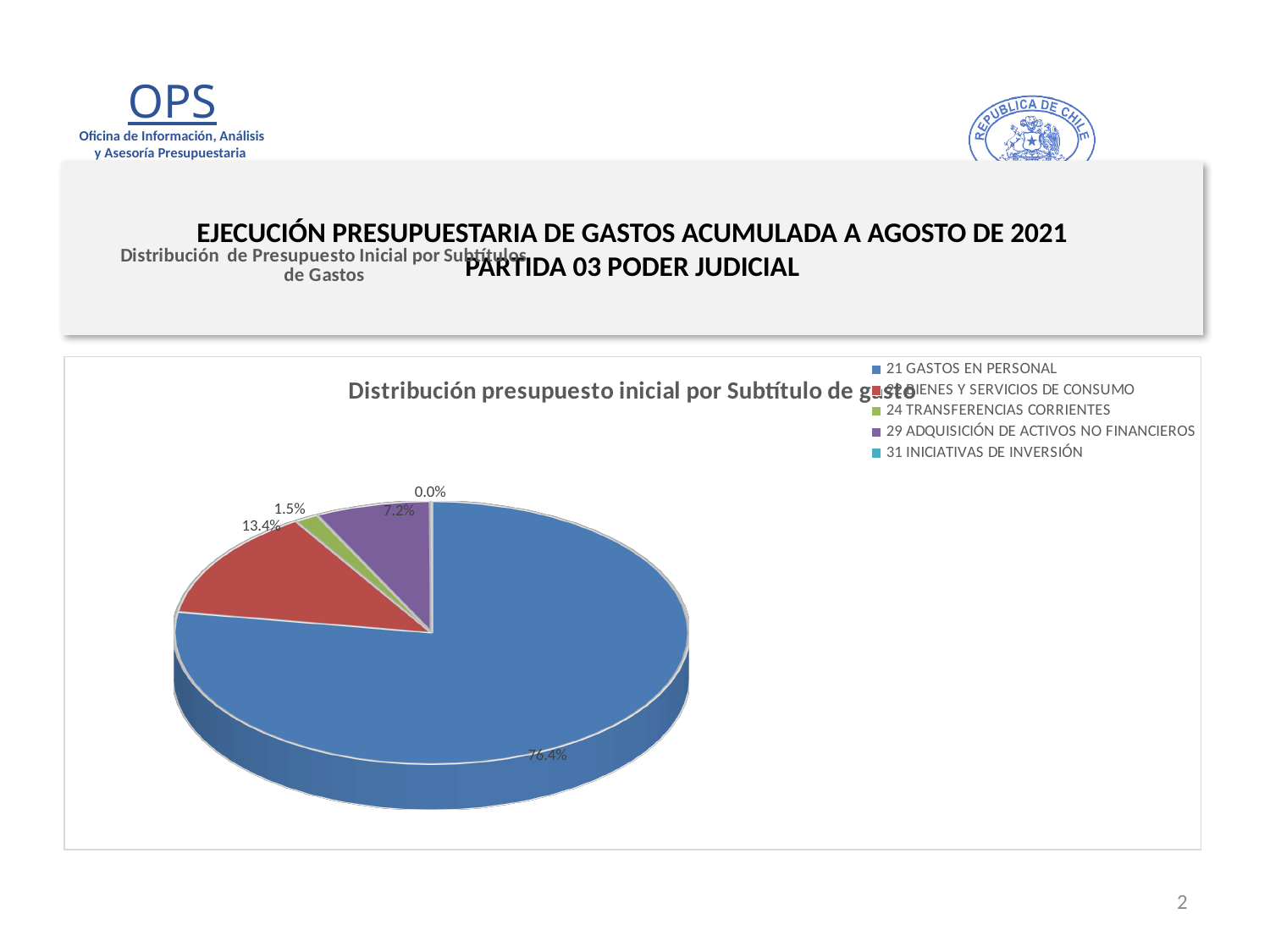
What percentage is shown for 24 TRANSFERENCIAS CORRIENTES? 1.5% What is the title of the pie chart? Distribución presupuesto inicial por Subtítulo de gasto Which is larger: the slice for 29 ADQUISICIÓN DE ACTIVOS NO FINANCIEROS or the slice for 24 TRANSFERENCIAS CORRIENTES? 29 ADQUISICIÓN DE ACTIVOS NO FINANCIEROS How many categories does the legend of the pie chart list? 5 What is the difference in percentage points between the 76.4% slice and the 13.4% slice? 63.0 percentage points Which category has the largest slice of the pie? 21 GASTOS EN PERSONAL What percentage is shown for 29 ADQUISICIÓN DE ACTIVOS NO FINANCIEROS? 7.2% What kind of chart is shown on the slide? pie chart What percentage is shown for 31 INICIATIVAS DE INVERSIÓN? 0.0% Which category has the smallest slice of the pie? 31 INICIATIVAS DE INVERSIÓN What percentage is shown for 22 BIENES Y SERVICIOS DE CONSUMO? 13.4% What share of the pie does 21 GASTOS EN PERSONAL have? 76.4%